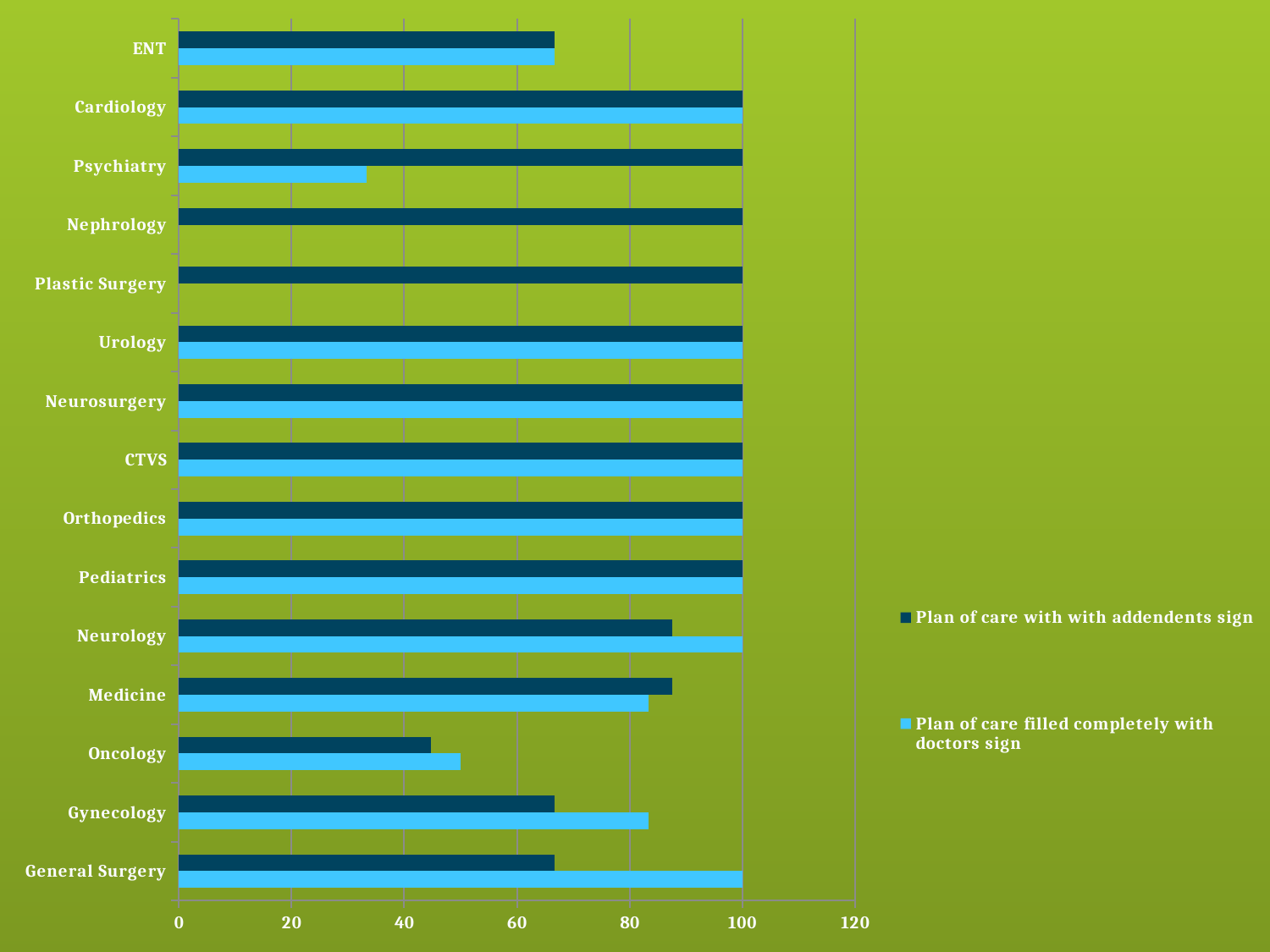
Is the value for Oncology in the 'Plan of care with with addendents sign' series greater or less than 40? greater What kind of chart is shown on the slide? bar chart Is the value for ENT in the 'Plan of care with with addendents sign' series greater or less than 60? greater How many series does the legend list? 2 For Psychiatry, which series has the larger value: 'Plan of care with with addendents sign' or 'Plan of care filled completely with doctors sign'? Plan of care with with addendents sign Which colour represents the 'Plan of care filled completely with doctors sign' series? light blue What is the value for Urology in the 'Plan of care filled completely with doctors sign' series? 100 Is the value for Gynecology in the 'Plan of care filled completely with doctors sign' series greater or less than 80? greater Which department has the lowest value in the 'Plan of care with with addendents sign' series? Oncology How many departments are shown on the vertical axis? 15 What is the value for Cardiology in the 'Plan of care with with addendents sign' series? 100